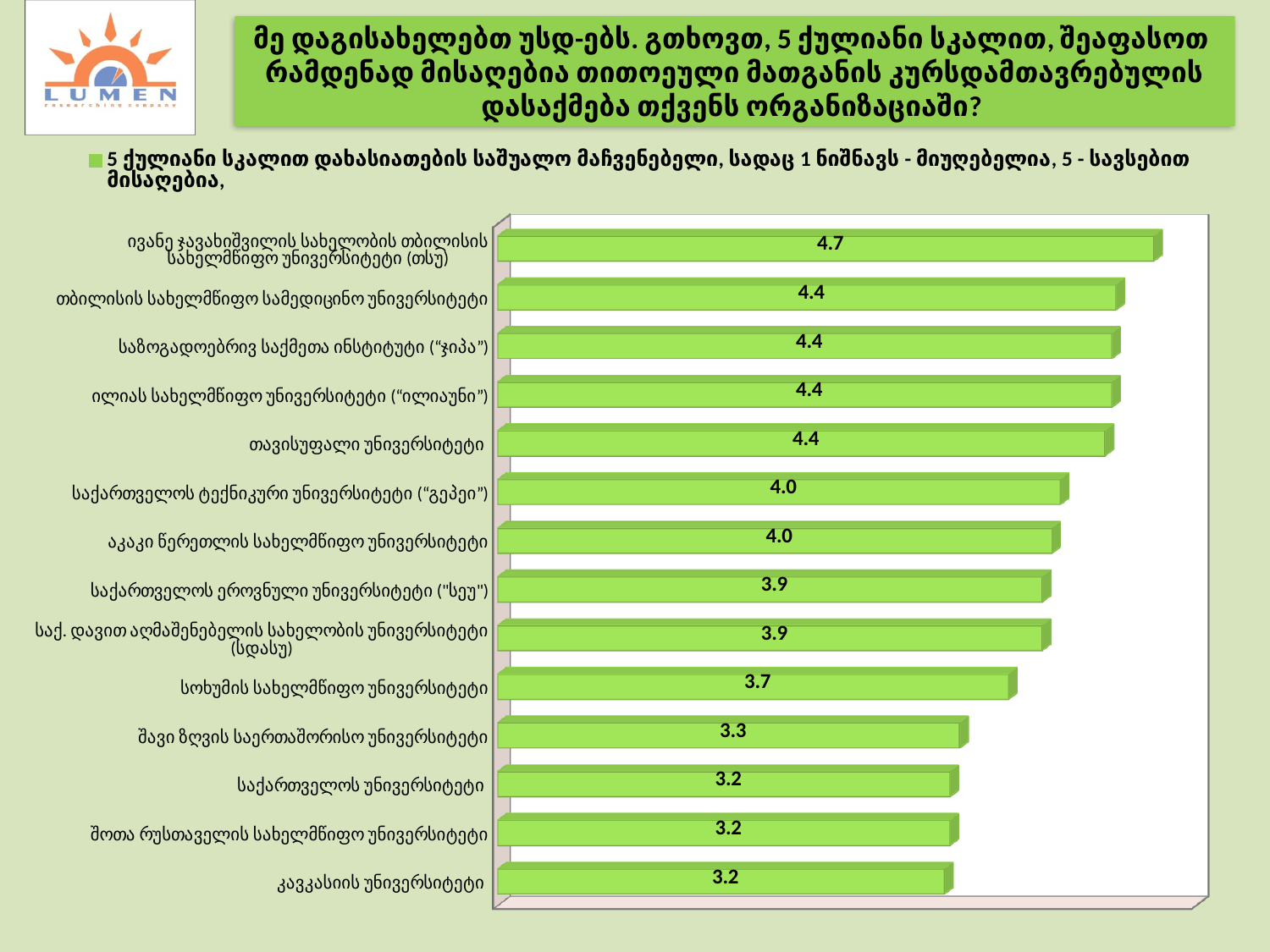
What is the lowest value shown in the chart? 3.2 What is the difference between the values for თსუ and სოხუმის სახელმწიფო უნივერსიტეტი? 1.0 What is the value for სოხუმის სახელმწიფო უნივერსიტეტი? 3.7 What is the value for შავი ზღვის საერთაშორისო უნივერსიტეტი? 3.3 What is the value for ივანე ჯავახიშვილის სახელობის თბილისის სახელმწიფო უნივერსიტეტი (თსუ)? 4.7 How many series does the legend list? 1 How many universities (categories) are plotted in the chart? 14 Which university has the highest value in the chart? ივანე ჯავახიშვილის სახელობის თბილისის სახელმწიფო უნივერსიტეტი (თსუ) Which has a larger value: სოხუმის სახელმწიფო უნივერსიტეტი or შავი ზღვის საერთაშორისო უნივერსიტეტი? სოხუმის სახელმწიფო უნივერსიტეტი What kind of chart is shown on the slide? bar chart Do the bar values increase or decrease going from the top of the chart to the bottom? decrease What is the value for საქართველოს ტექნიკური უნივერსიტეტი ("გეპეი")? 4.0